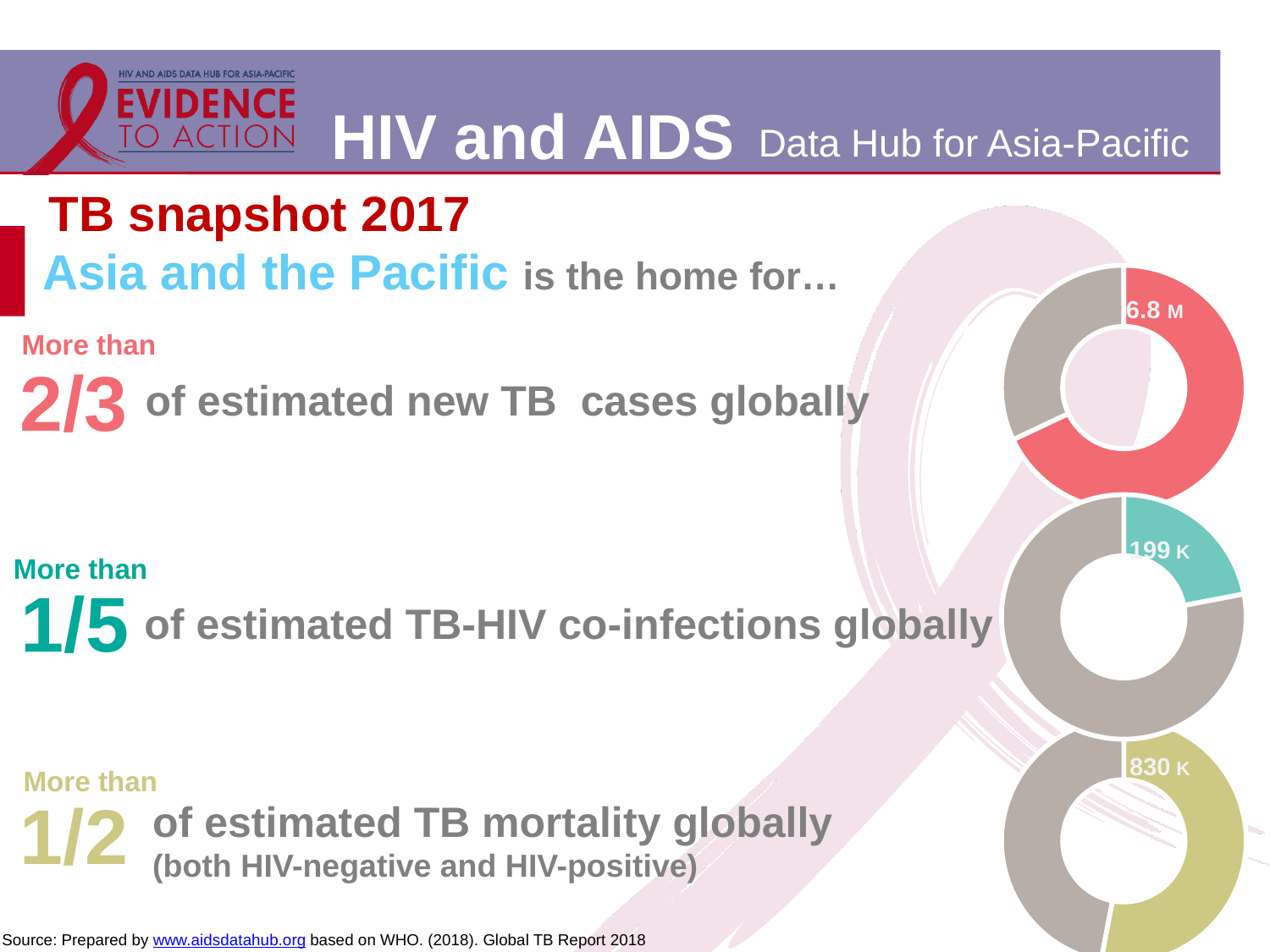
What value is labelled on the top donut chart (new TB cases)? 6.8 M According to the slide, what share of estimated TB mortality globally does Asia and the Pacific account for? More than 1/2 In the middle donut chart, which slice is larger: the teal slice or the grey slice? The grey slice In the top donut chart, which slice is larger: the red slice or the grey slice? The red slice According to the slide, what share of estimated TB-HIV co-infections globally does Asia and the Pacific account for? More than 1/5 What colour is the highlighted slice in the middle donut chart for TB-HIV co-infections? Teal What value is labelled on the middle donut chart (TB-HIV co-infections)? 199 K How many donut charts are shown on the slide? 3 What kind of chart is used to show the Asia-Pacific share of new TB cases? Donut (pie) chart In the bottom donut chart, which slice is larger: the yellow slice or the grey slice? The yellow slice What value is labelled on the bottom donut chart (TB mortality)? 830 K According to the slide, what share of estimated new TB cases globally does Asia and the Pacific account for? More than 2/3